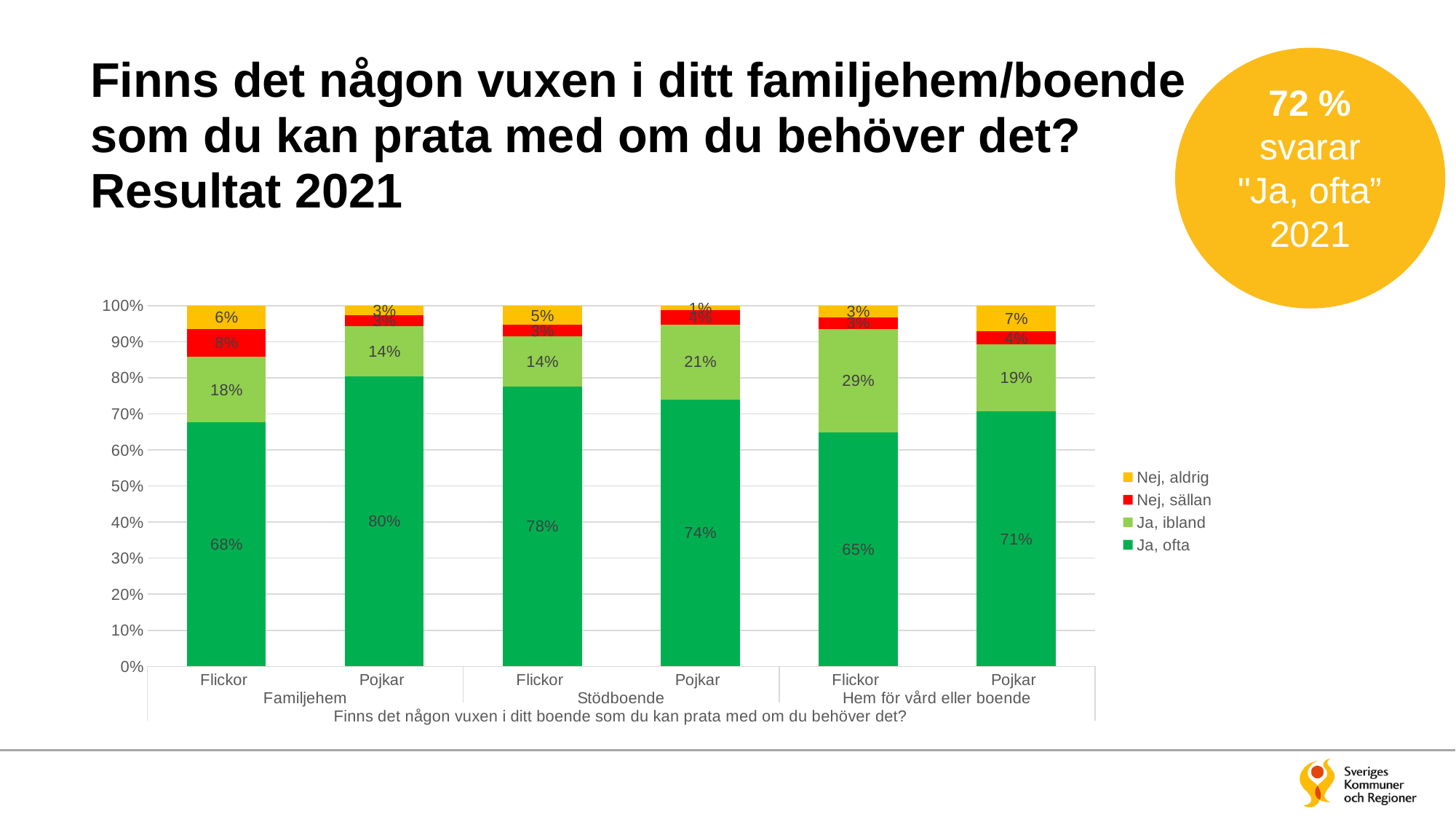
Which bar has the lowest "Ja, ofta" value? Flickor, Hem för vård eller boende What kind of chart is shown on the slide? Stacked bar chart Which colour represents "Nej, aldrig" in the legend? Yellow What is the "Ja, ibland" value for Flickor in Hem för vård eller boende? 29% Which is larger: the "Ja, ibland" value for Pojkar in Stödboende or for Pojkar in Hem för vård eller boende? Pojkar in Stödboende What is the "Ja, ofta" value for Flickor in Familjehem? 68% What is the "Nej, aldrig" value for Pojkar in Hem för vård eller boende? 7% How many series does the legend list? 4 Which bar has the highest "Ja, ofta" value? Pojkar, Familjehem How many bars are shown in the chart? 6 What is the difference between the "Ja, ofta" values for Pojkar and Flickor in Familjehem? 12 percentage points What is the "Nej, sällan" value for Flickor in Familjehem? 8%